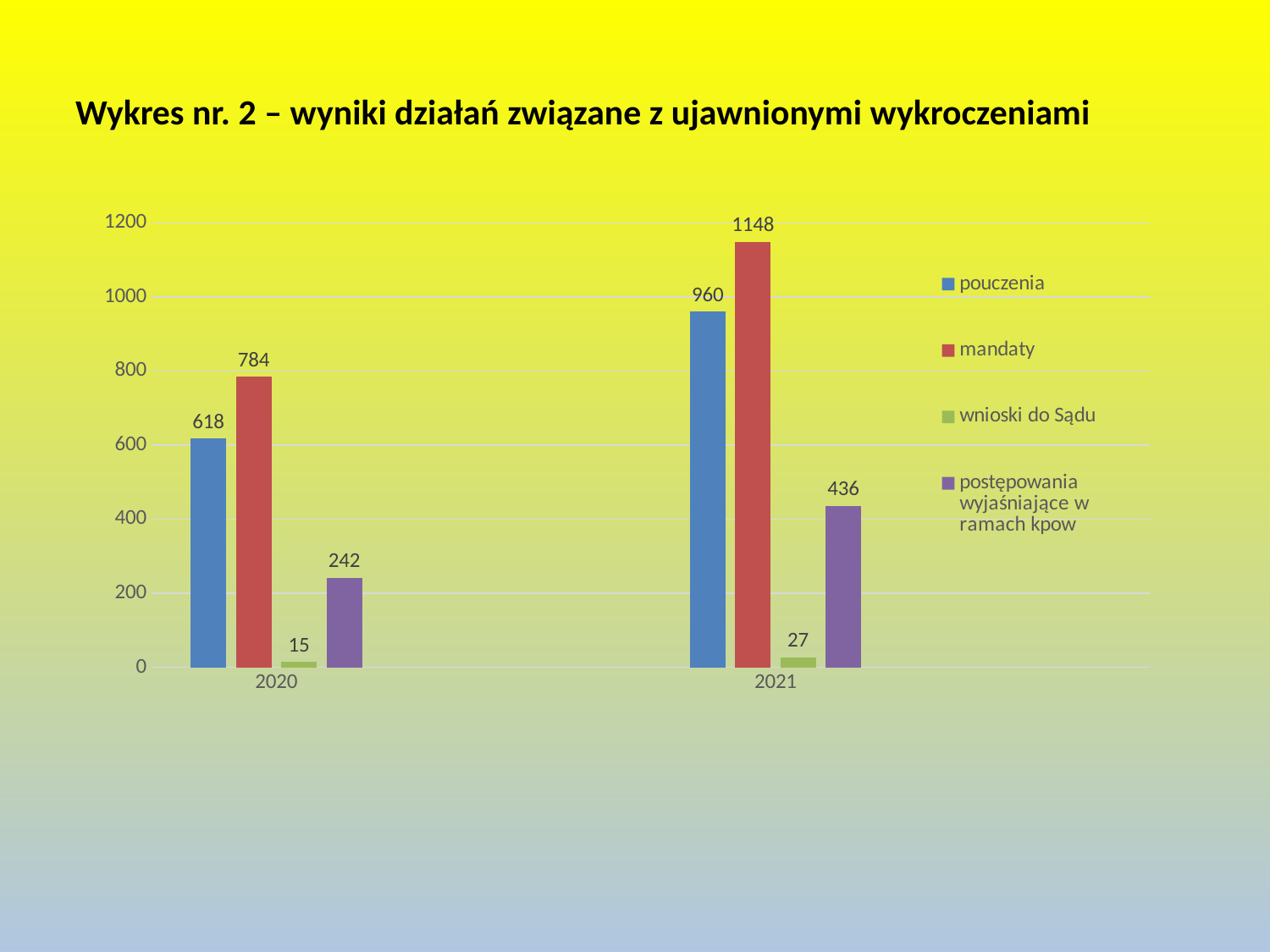
Do the values for pouczenia rise or fall from 2020 to 2021? rise What is the value of wnioski do Sądu in 2021? 27 What is the value of pouczenia in 2020? 618 How many series does the legend list? 4 Which series has the lowest value in 2020? wnioski do Sądu What is the difference between mandaty in 2021 and mandaty in 2020? 364 How many categories are shown on the x axis? 2 What kind of chart is shown on the slide? bar chart What is the value of mandaty in 2021? 1148 What is the value of postępowania wyjaśniające w ramach kpow in 2020? 242 Which is larger: pouczenia in 2021 or mandaty in 2020? pouczenia in 2021 Which series has the highest value in 2021? mandaty